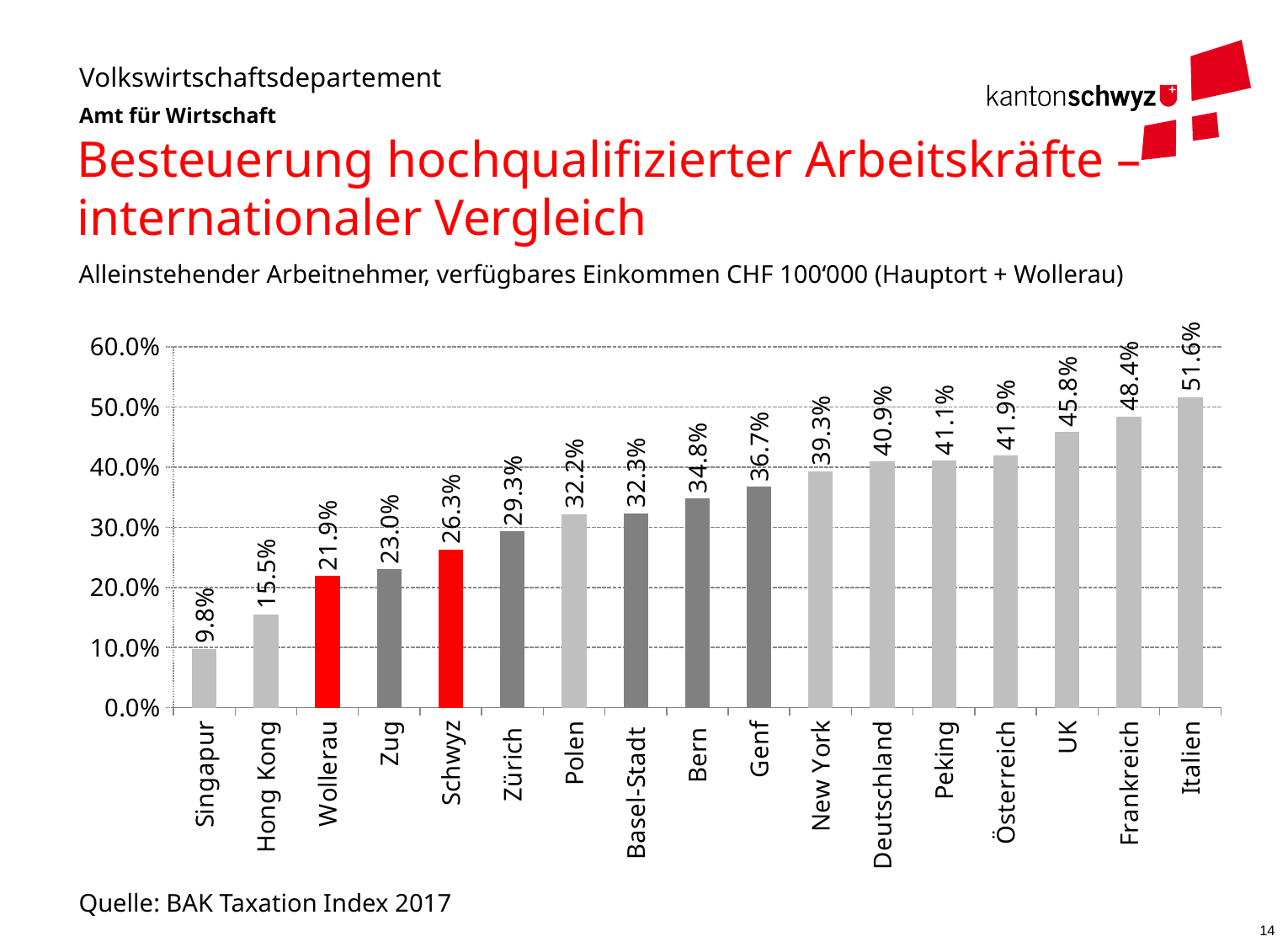
Which category has the lowest value? Singapur How many categories are shown on the x axis? 17 Which is larger, the value for Zürich or the value for Genf? Genf Is the value for UK greater or less than 40.0%? greater What is the value for Schwyz? 26.3% Which bars are highlighted in red? Wollerau and Schwyz What kind of chart is shown on the slide? bar chart Which category has the highest value? Italien What is the difference between the values for Zug and Schwyz? 3.3% What is the value for Wollerau? 21.9% What is the difference between the values for Italien and Singapur? 41.8% What is the value for Deutschland? 40.9%